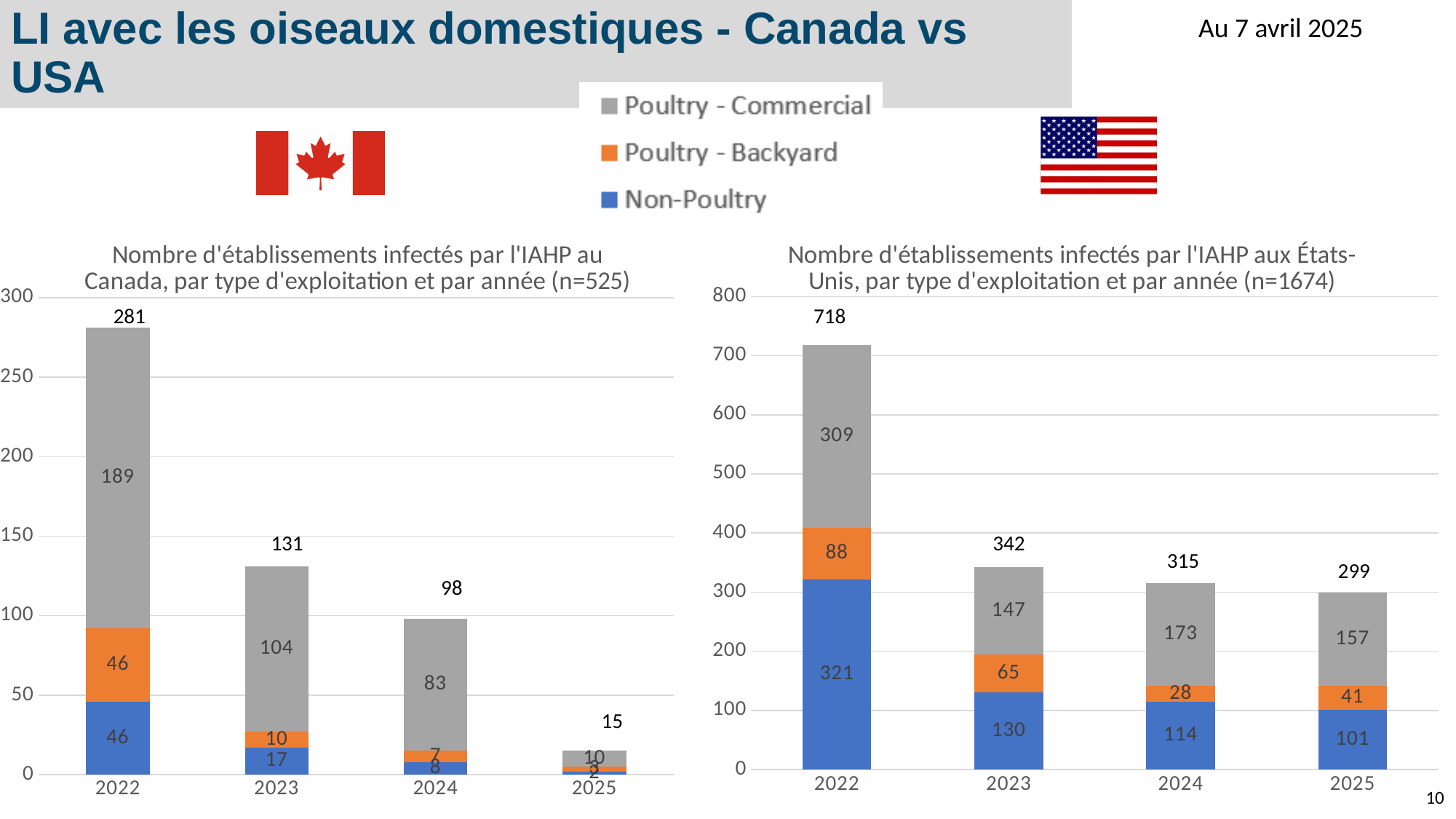
In the USA chart (right), what is the Poultry - Commercial value for 2024? 173 In the Canada chart (left), which is larger in 2024: Poultry - Commercial or Non-Poultry? Poultry - Commercial In the USA chart (right), is the total for 2023 greater or less than 300? greater In the Canada chart (left), which year has the lowest total? 2025 In the Canada chart (left), what is the Poultry - Backyard value for 2023? 10 How many years are shown on the x axis of the Canada chart (left)? 4 How many series does the shared legend list? 3 In the Canada chart (left), what is the total number of infected establishments in 2022? 281 In the USA chart (right), what is the difference between the Non-Poultry values for 2022 and 2023? 191 In the USA chart (right), which year has the highest total? 2022 What kind of chart is the USA chart (right)? stacked bar chart In the USA chart (right), do the yearly totals rise or fall from 2022 to 2025? fall